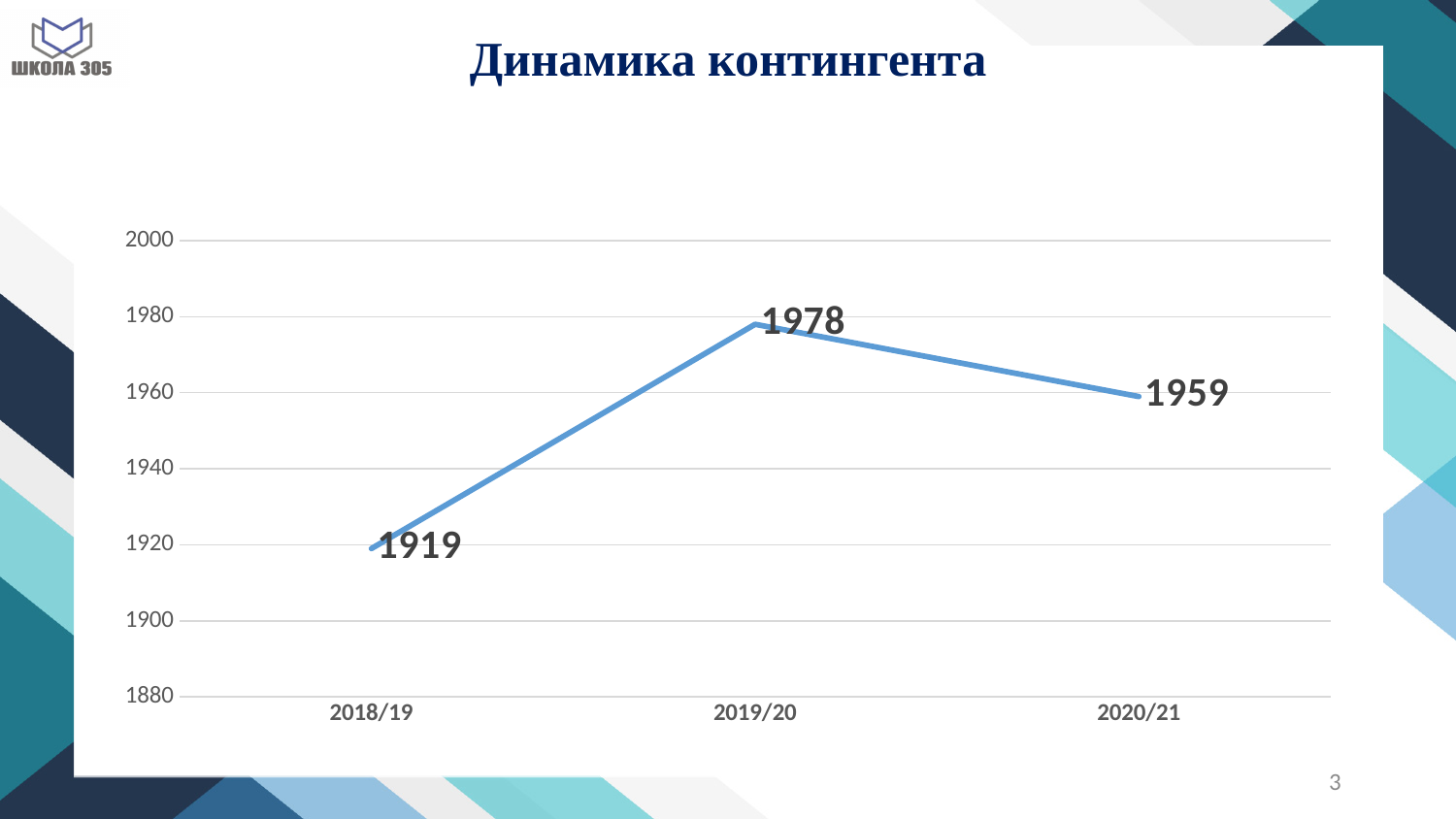
What is the value for 2018/19? 1919 What is the title of the chart? Динамика контингента What is the difference between the values for 2019/20 and 2020/21? 19 How many points are plotted on the chart? 3 Which is larger, the value for 2020/21 or the value for 2018/19? 2020/21 Which year has the highest value? 2019/20 Which year has the lowest value? 2018/19 What is the value for 2019/20? 1978 What is the difference between the values for 2019/20 and 2018/19? 59 What kind of chart is shown on the slide? line chart What is the value for 2020/21? 1959 Is the value for 2020/21 greater or less than 1940? greater